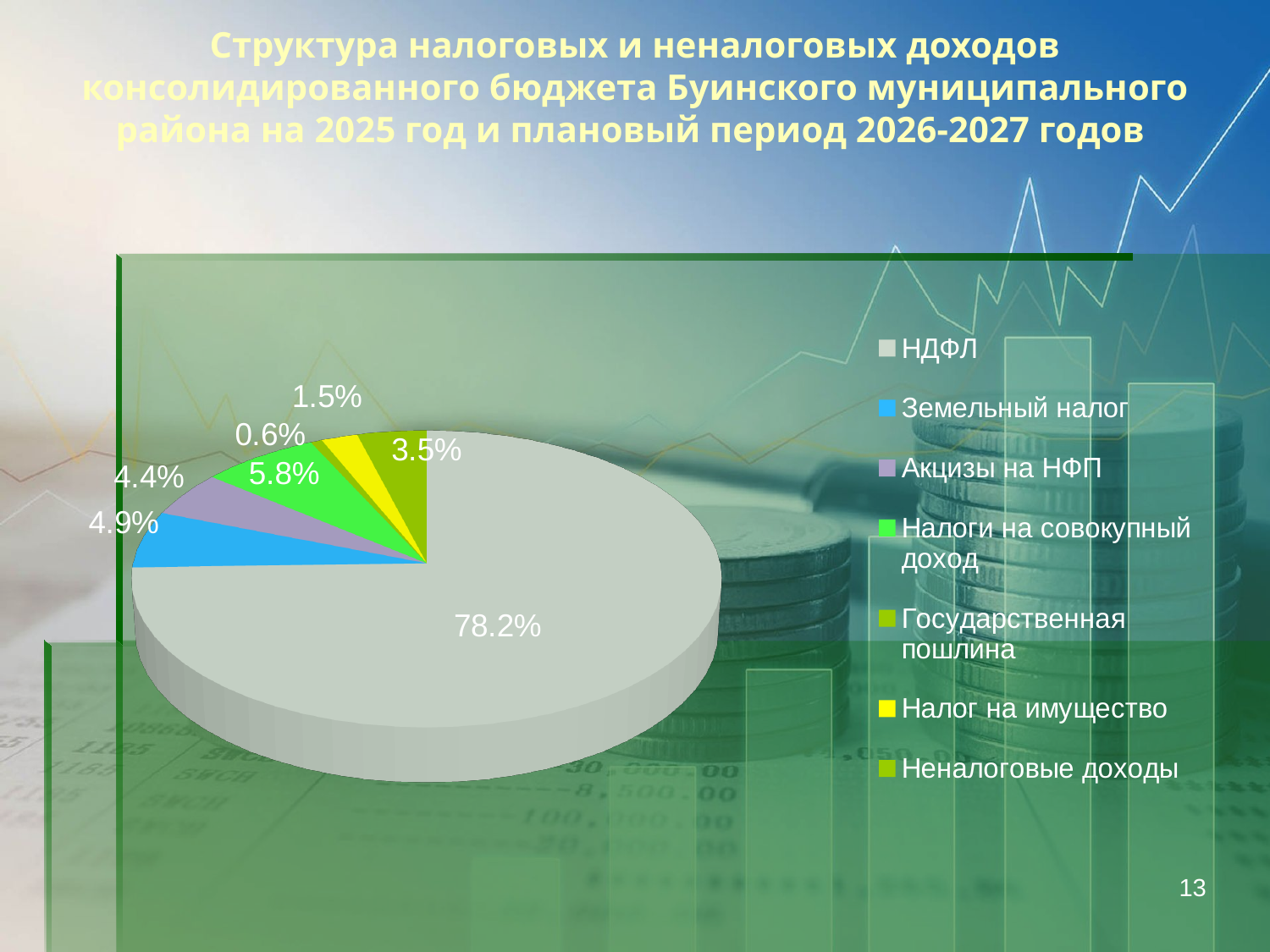
What is the value shown for Земельный налог? 4.9% What share of the pie does НДФЛ account for? 78.2% What is the value shown for Неналоговые доходы? 3.5% How many categories does the legend list? 7 What is the difference between the shares of Налоги на совокупный доход and Налог на имущество? 4.3% Which category has the smallest share of the pie? Государственная пошлина What is the value shown for Налоги на совокупный доход? 5.8% What colour is the slice for Земельный налог? blue Which is larger, the share for Земельный налог or the share for Акцизы на НФП? Земельный налог What type of chart is shown on the slide? pie chart What is the value shown for Акцизы на НФП? 4.4% Which category has the largest share of the pie? НДФЛ